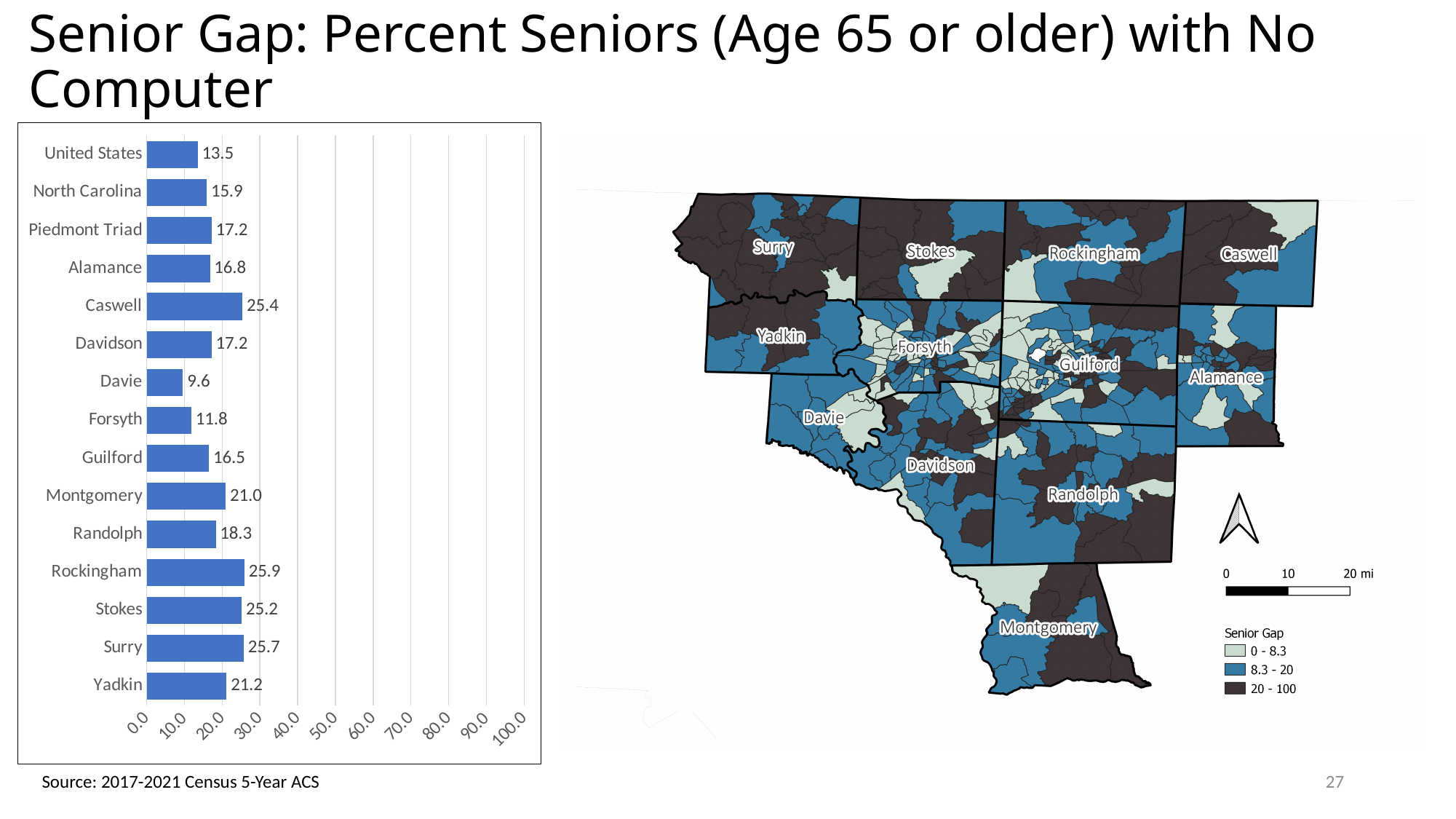
What is the value for Rockingham in the bar chart? 25.9 Which category has the highest value in the bar chart? Rockingham What is the difference between the values for Caswell and Forsyth in the bar chart? 13.6 Which category has the lowest value in the bar chart? Davie What is the value for the United States in the bar chart? 13.5 How many categories are shown in the bar chart? 15 What kind of chart is shown on the left of the slide? Bar chart What is the difference between the values for North Carolina and the United States in the bar chart? 2.4 What is the value for Piedmont Triad in the bar chart? 17.2 What is the source cited below the bar chart? 2017-2021 Census 5-Year ACS Which has a larger value in the bar chart, Montgomery or Guilford? Montgomery What is the value for Davie in the bar chart? 9.6